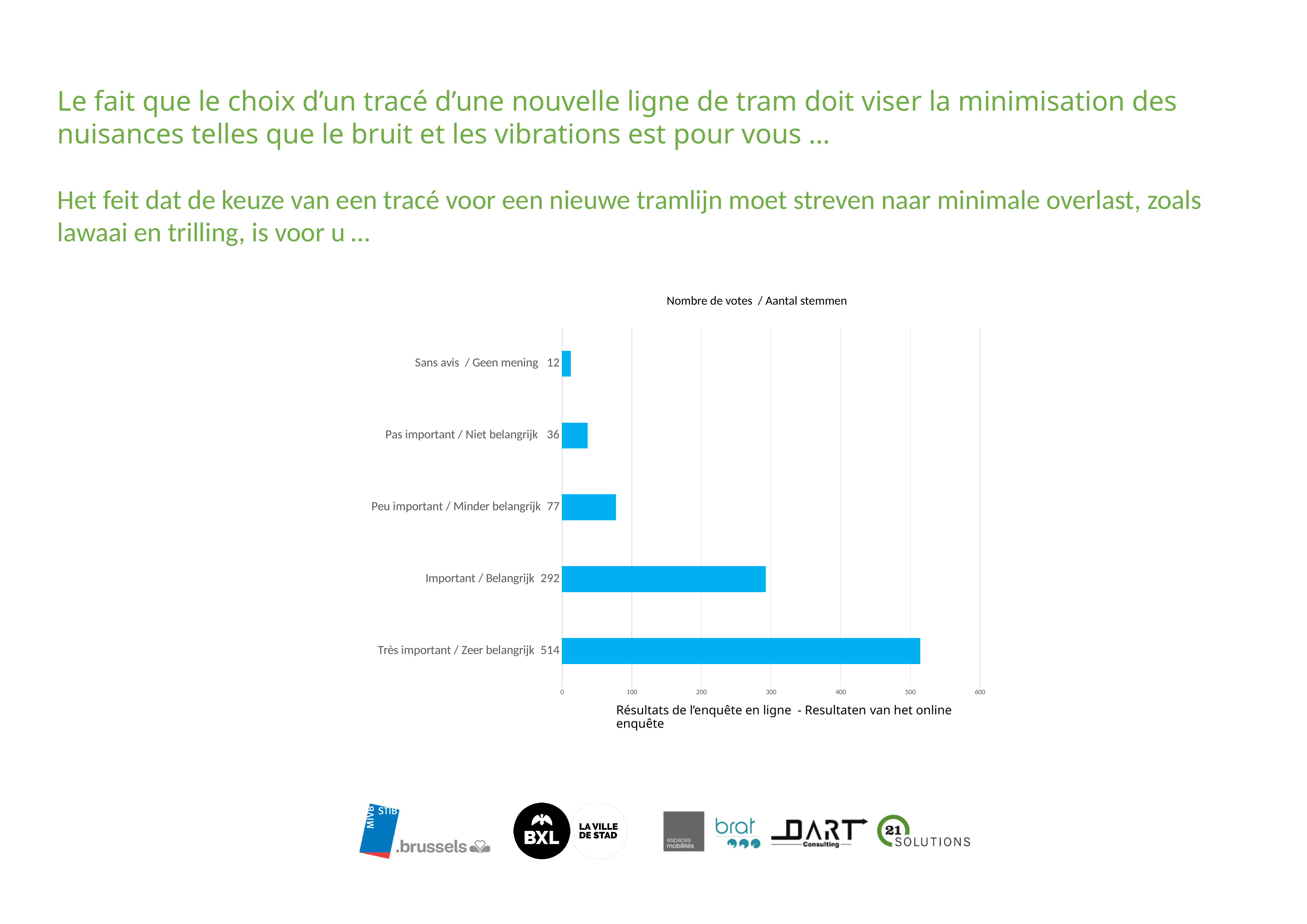
Which category received the fewest votes? Sans avis / Geen mening What is the number of votes for "Peu important / Minder belangrijk"? 77 What is the number of votes for "Très important / Zeer belangrijk"? 514 What is the number of votes for "Important / Belangrijk"? 292 What is the title of the chart? Nombre de votes / Aantal stemmen Which has more votes: "Pas important / Niet belangrijk" or "Peu important / Minder belangrijk"? Peu important / Minder belangrijk How many categories are shown in the chart? 5 Which category received the most votes? Très important / Zeer belangrijk What is the difference in votes between "Très important / Zeer belangrijk" and "Important / Belangrijk"? 222 Is the value for "Important / Belangrijk" greater or less than 300? less What kind of chart is shown on the slide? Bar chart What is the number of votes for "Sans avis / Geen mening"? 12